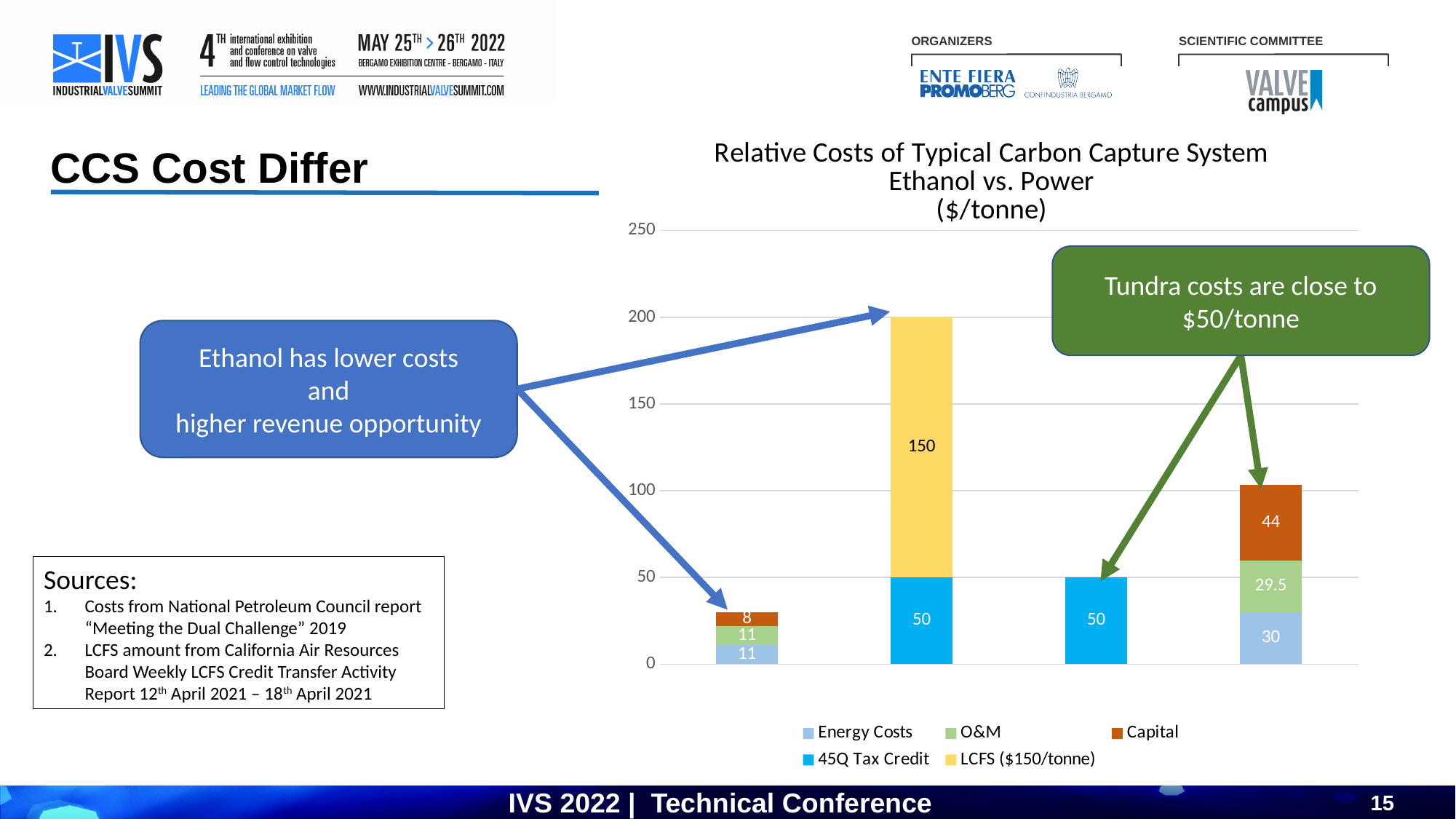
What is the LCFS ($150/tonne) value in the second bar? 150 What is the Energy Costs value in the fourth (rightmost) bar? 30 What is the total of the first (leftmost) stacked bar? 30 What is the O&M value in the fourth (rightmost) bar? 29.5 What is the Capital value in the first (leftmost) bar? 8 What is the difference between the Capital value in the fourth bar and the Capital value in the first bar? 36 Which bar is the tallest in the chart? The second bar How many series does the chart legend list? 5 What kind of chart is shown on the slide? Stacked bar chart What is the total of the second stacked bar? 200 Which legend entry is shown in yellow? LCFS ($150/tonne) How many bars are plotted in the chart? 4